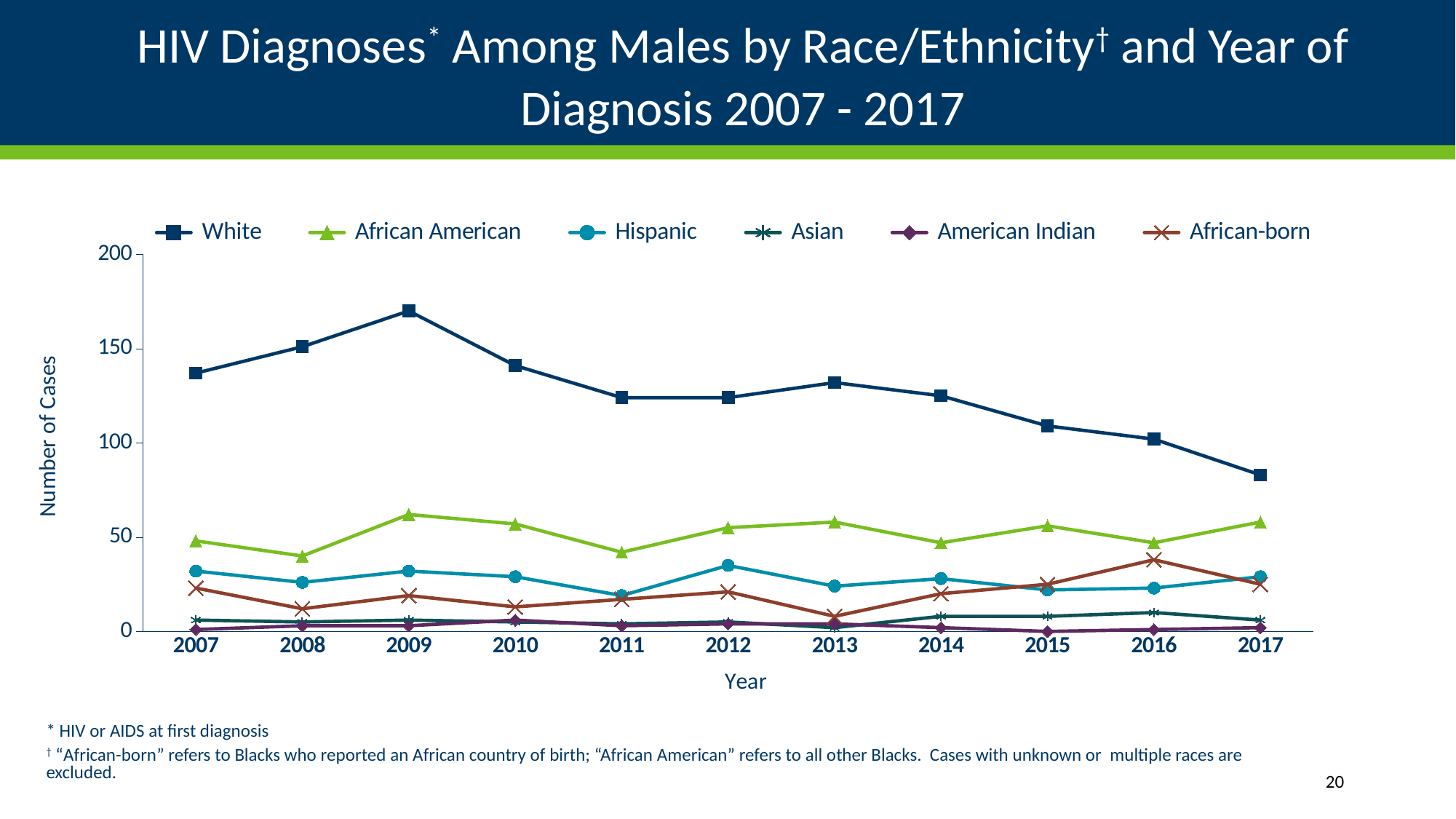
Does the White series rise or fall from 2009 to 2017? fall Which is larger in 2009, the value for African American or the value for Hispanic? African American Which series has the highest values across all years? White In which year does the White series reach its highest value? 2009 What is the label on the y axis? Number of Cases How many years are plotted along the x axis? 11 Is the value for White in 2009 greater or less than 150? greater What kind of chart is shown on the slide? line chart Is the value for African American in 2008 greater or less than 50? less How many series does the legend list? 6 Is the value for White in 2017 greater or less than 100? less In which year does the White series reach its lowest value? 2017